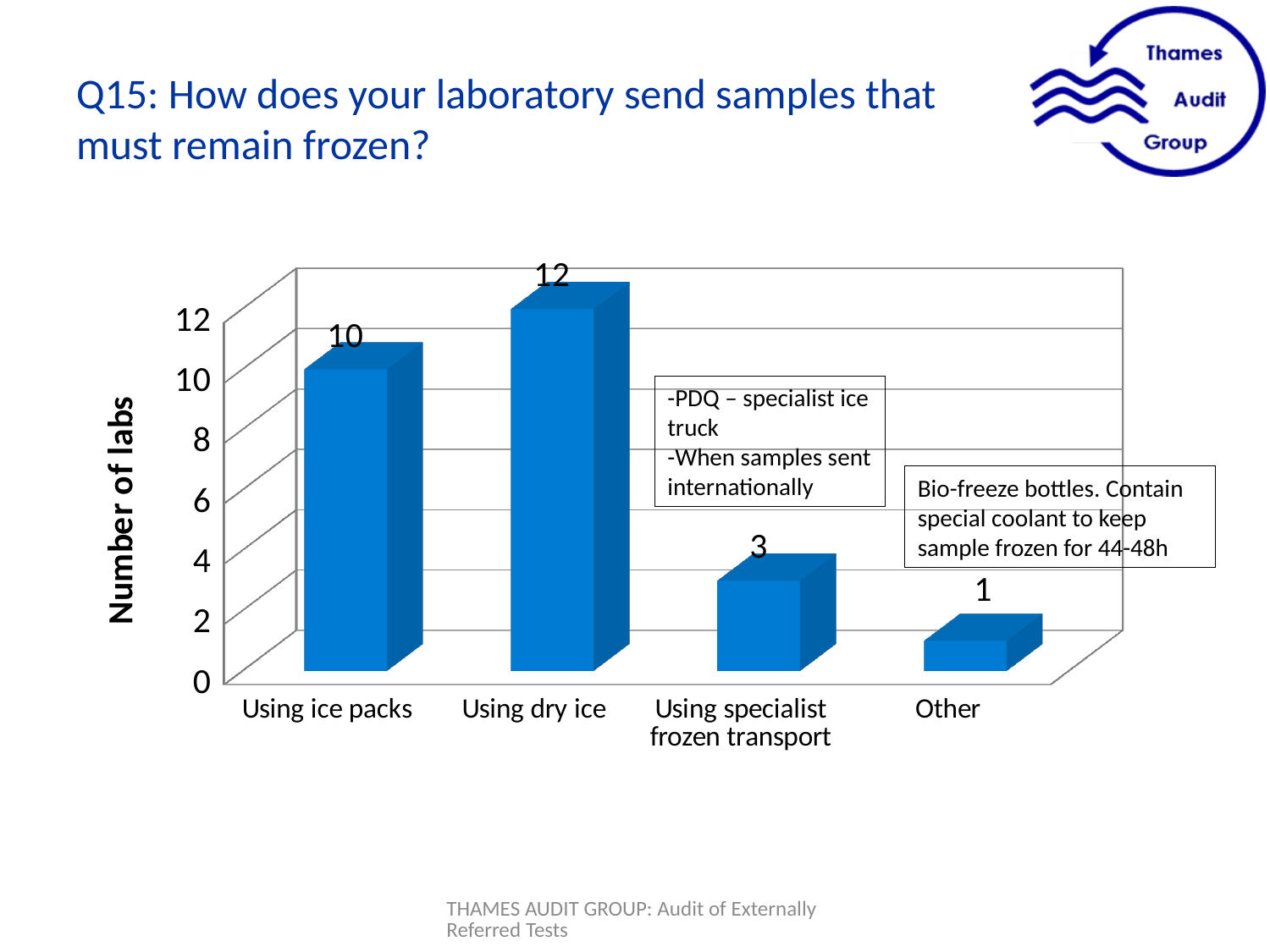
How many labs send frozen samples using ice packs? 10 Which method is used by the most labs? Using dry ice What type of chart is shown on the slide? Bar chart What is the difference between the number of labs using dry ice and the number using ice packs? 2 How many labs send frozen samples using dry ice? 12 How many labs use specialist frozen transport? 3 What is the label of the vertical axis? Number of labs What is the difference between the number of labs using specialist frozen transport and the number in 'Other'? 2 How many categories are shown on the x axis? 4 Which category has the fewest labs? Other Which has more labs: using ice packs or using specialist frozen transport? Using ice packs How many labs are in the 'Other' category? 1